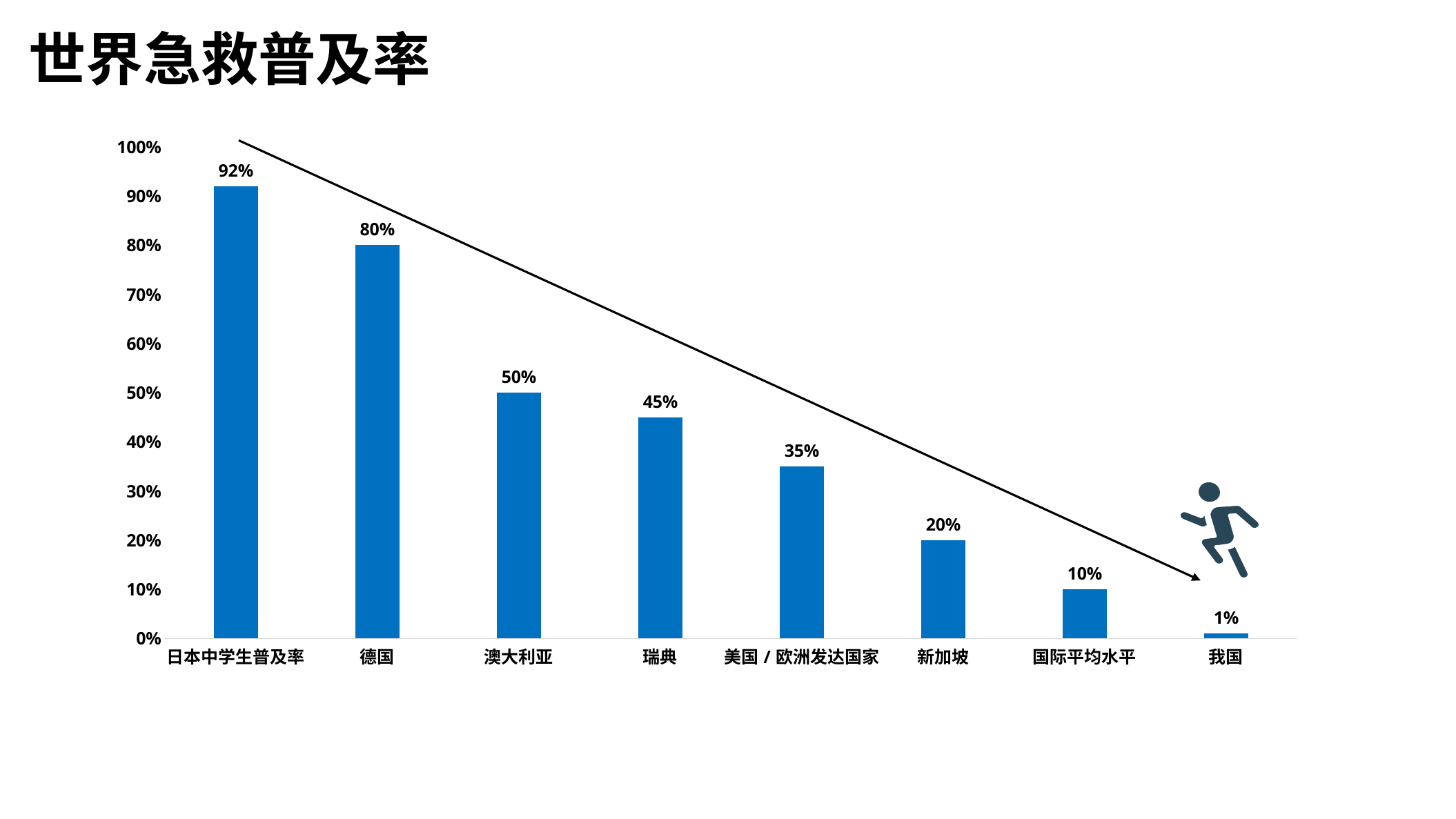
What is the value for 国际平均水平? 10% What is the value for 美国 / 欧洲发达国家? 35% What is the value for 德国? 80% How many categories are shown on the x axis? 8 Which category has the highest value? 日本中学生普及率 What is the difference between the values for 国际平均水平 and 我国? 9% Which is larger, the value for 澳大利亚 or the value for 瑞典? 澳大利亚 What is the value for 我国? 1% Do the values rise or fall from left to right along the x axis? fall What kind of chart is shown on the slide? bar chart What is the difference between the values for 日本中学生普及率 and 德国? 12% Which category has the lowest value? 我国